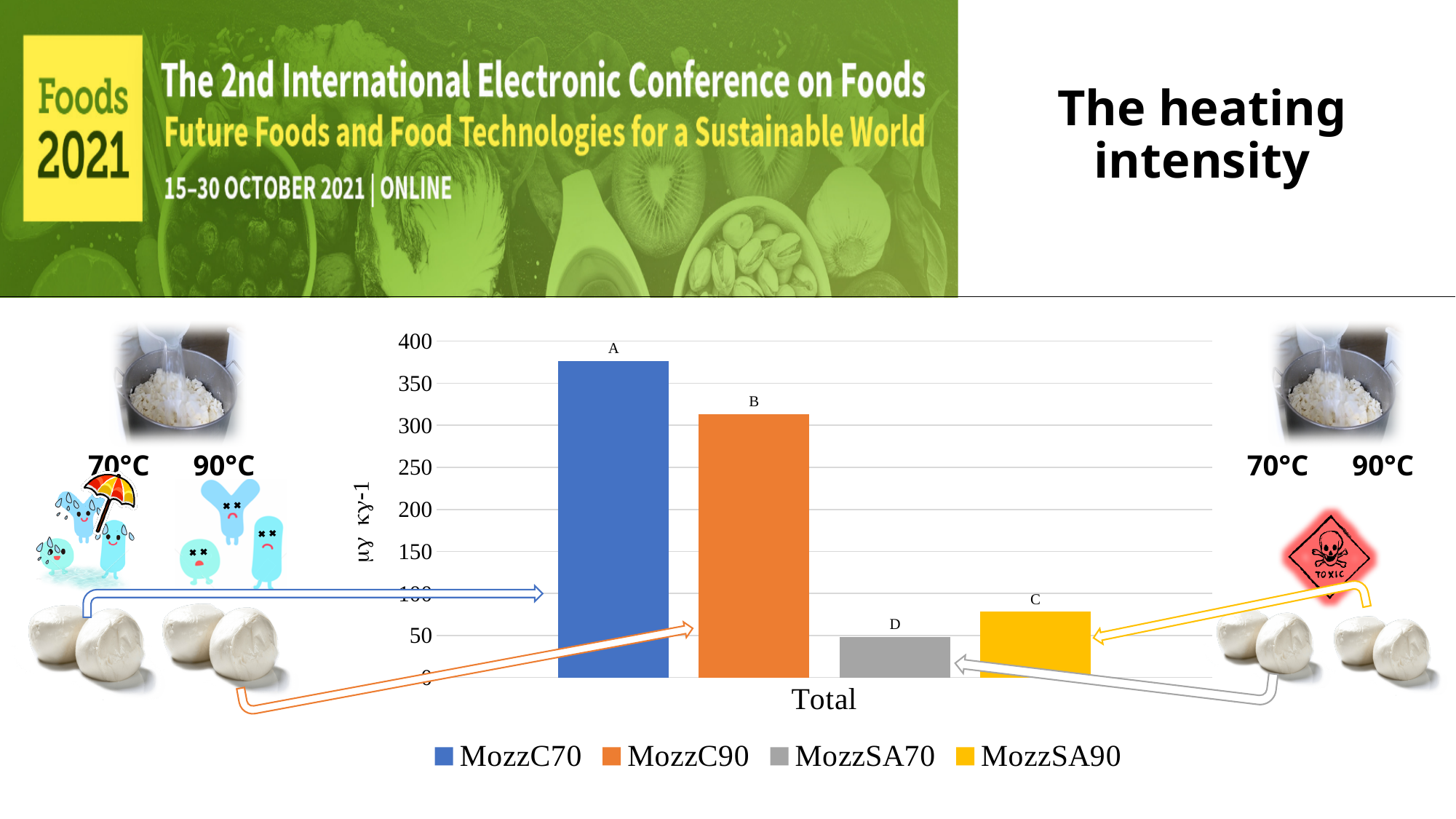
Is the value for MozzC90 greater or less than 300? greater Which is larger, the bar for MozzSA90 or the bar for MozzSA70? MozzSA90 Is the value for MozzC70 greater or less than 350? greater What colour is the bar for MozzSA90 in the chart? yellow What is the category label shown on the x axis of the chart? Total Which series has the highest bar in the chart? MozzC70 Is the value for MozzSA90 greater or less than 100? less Which is larger, the bar for MozzC90 or the bar for MozzSA90? MozzC90 What kind of chart is shown on the slide? bar chart Which series has the lowest bar in the chart? MozzSA70 How many series does the chart legend list? 4